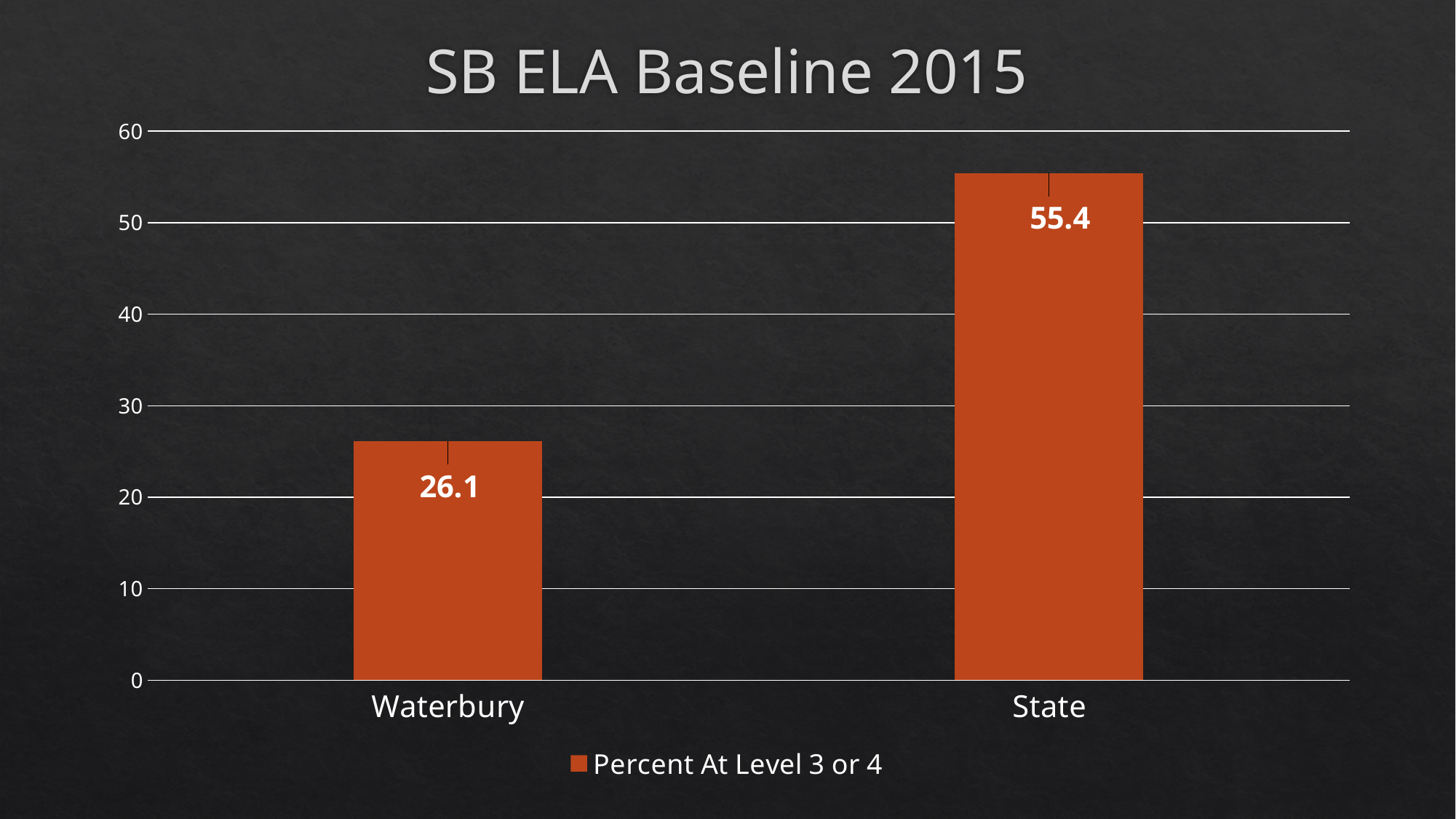
What is the value for Waterbury? 26.1 What is the difference between the State value and the Waterbury value? 29.3 How many categories are shown on the x axis? 2 What is the title of the chart? SB ELA Baseline 2015 How many series does the legend list? 1 Is the value for Waterbury greater or less than 30? less Is the value for State greater or less than 50? greater Which category has the highest value? State What is the value for State? 55.4 Which category has the lowest value? Waterbury Which is larger, the value for Waterbury or the value for State? State What kind of chart is shown on the slide? bar chart